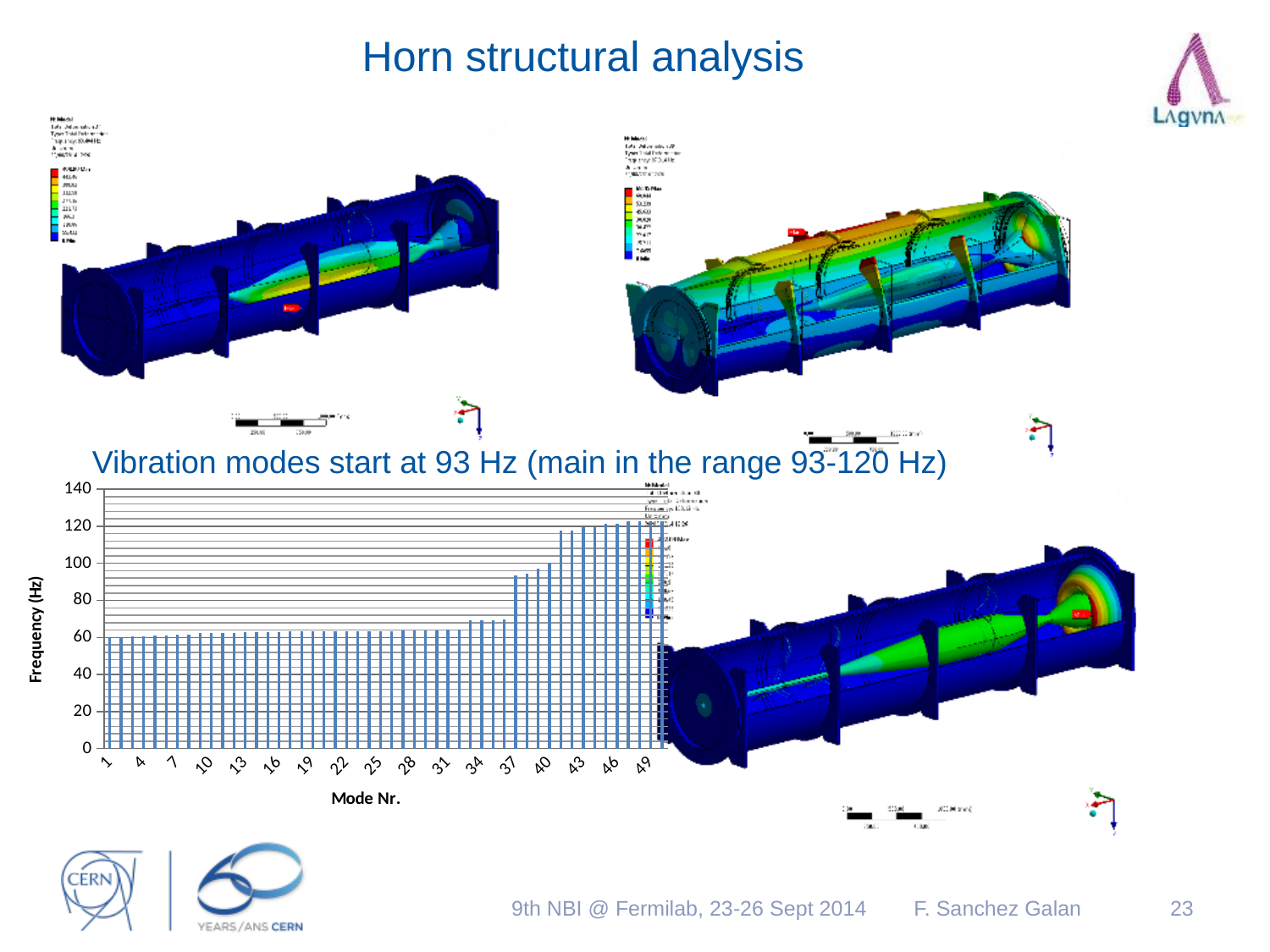
Is the frequency for mode 37 greater or less than 100? less Is the frequency for mode 1 greater or less than 80? less Is the frequency for mode 43 greater or less than 100? greater Do the frequency values generally rise or fall as the mode number increases along the x axis? rise Which has the higher frequency, mode 1 or mode 49? mode 49 Which has the higher frequency, mode 22 or mode 46? mode 46 What is the title of the vertical axis of the bar chart? Frequency (Hz) What is the title of the horizontal axis of the bar chart? Mode Nr. What kind of chart is shown on the slide? bar chart